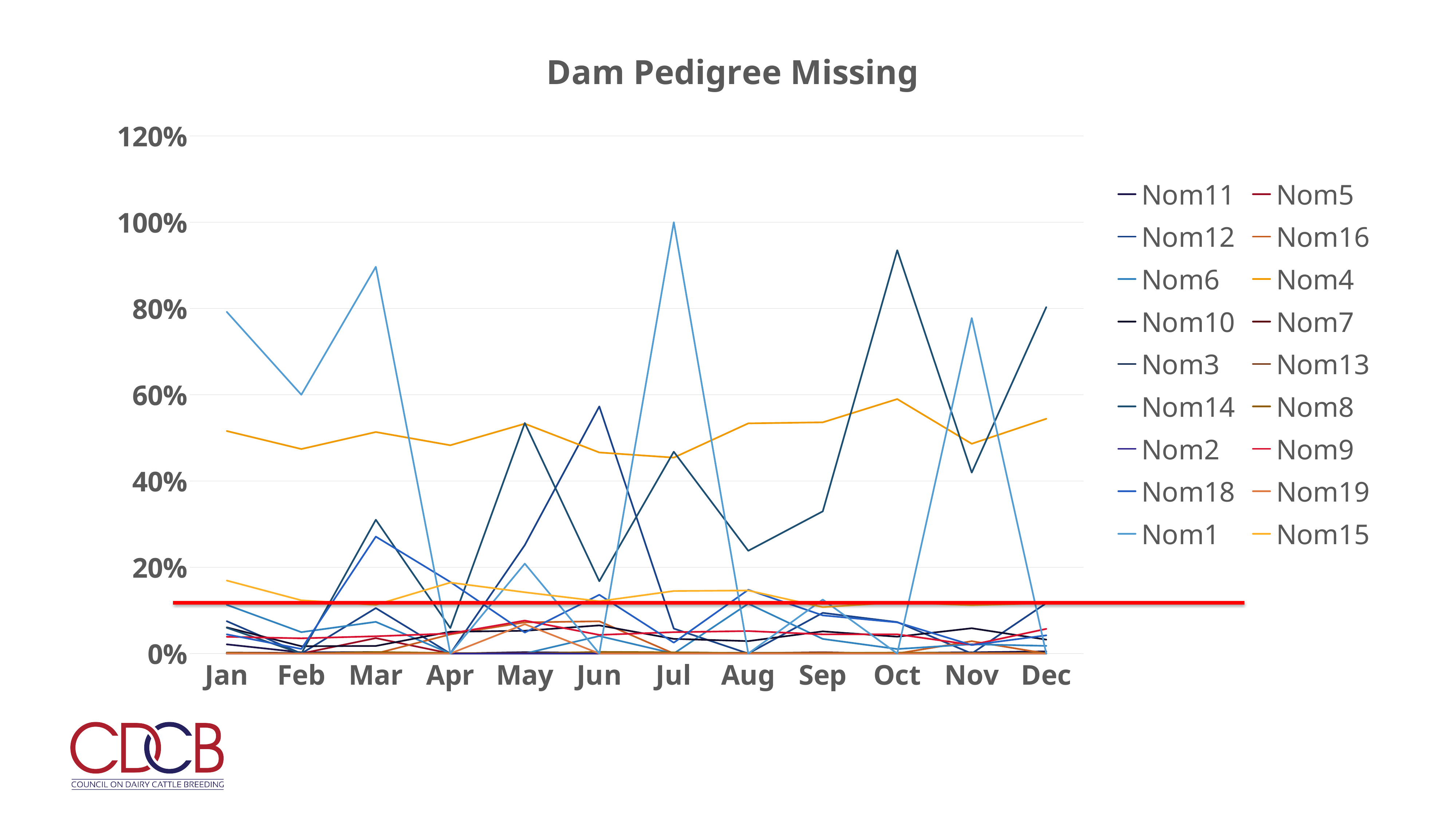
In Dec, which is larger: the value for Nom14 or the value for Nom4? Nom14 What is the title of the chart? Dam Pedigree Missing Does the value for Nom14 rise or fall from Sep to Oct? rise How many series does the legend list? 18 What kind of chart is shown on the slide? line chart Is the value for Nom4 in Jan greater or less than 40%? greater Is the value for Nom14 in Oct greater or less than 80%? greater In which month does Nom14 reach its highest value? Oct Is the value for Nom14 in Feb greater or less than 20%? less How many months are shown along the x axis? 12 In which month does Nom4 reach its highest value? Oct